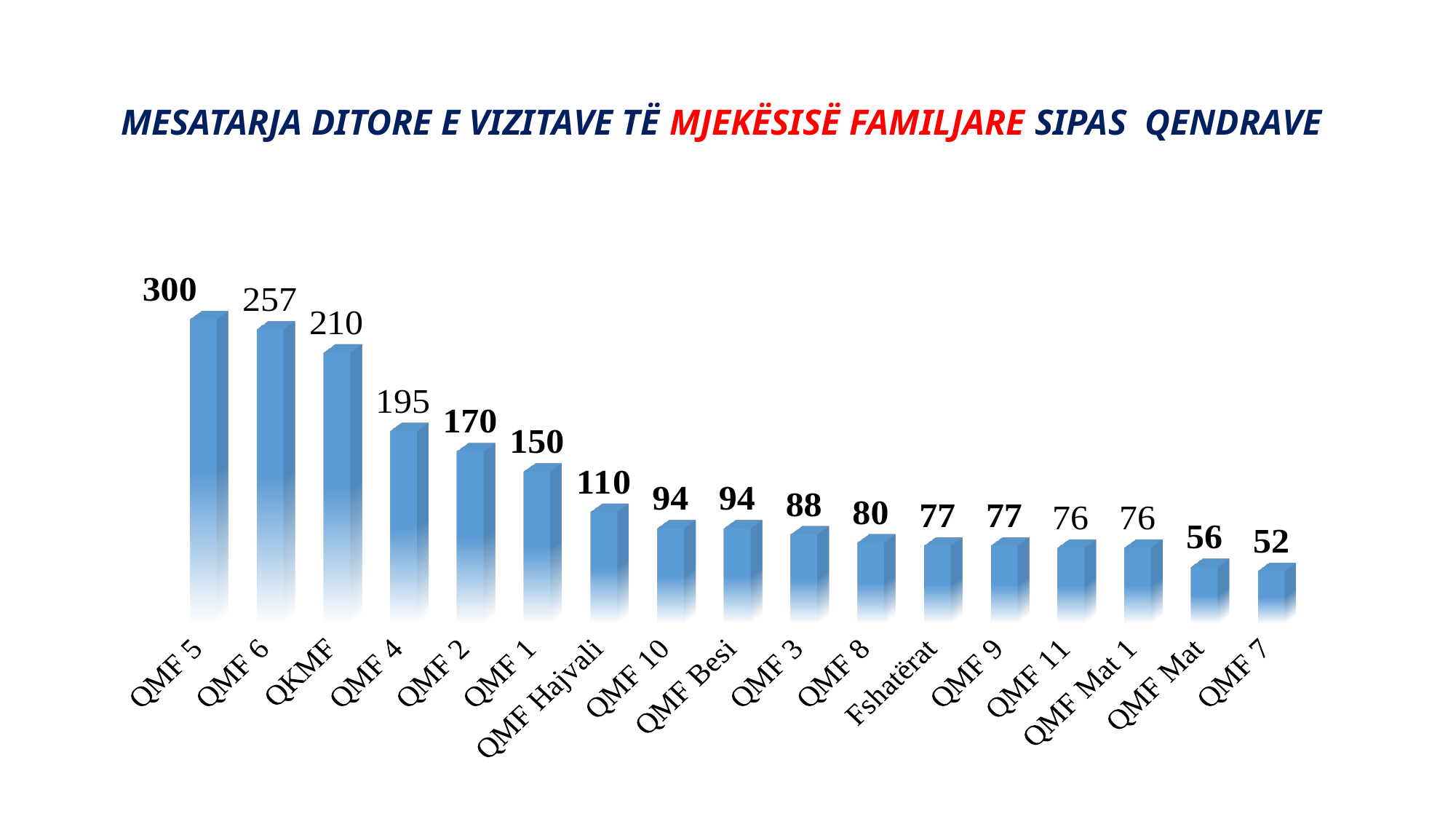
How many categories are shown in the chart? 17 What kind of chart is shown on the slide? Bar chart Which category has the highest value? QMF 5 What is the value for QMF 5? 300 What is the value for QMF Mat 1? 76 Do the values rise or fall from left to right along the x axis? Fall What is the value for Fshatërat? 77 What is the difference between the values for QMF 2 and QMF 1? 20 Which is larger, the value for QMF 4 or the value for QMF 3? QMF 4 Which category has the lowest value? QMF 7 What is the value for QMF Hajvali? 110 What is the difference between the values for QMF 6 and QKMF? 47